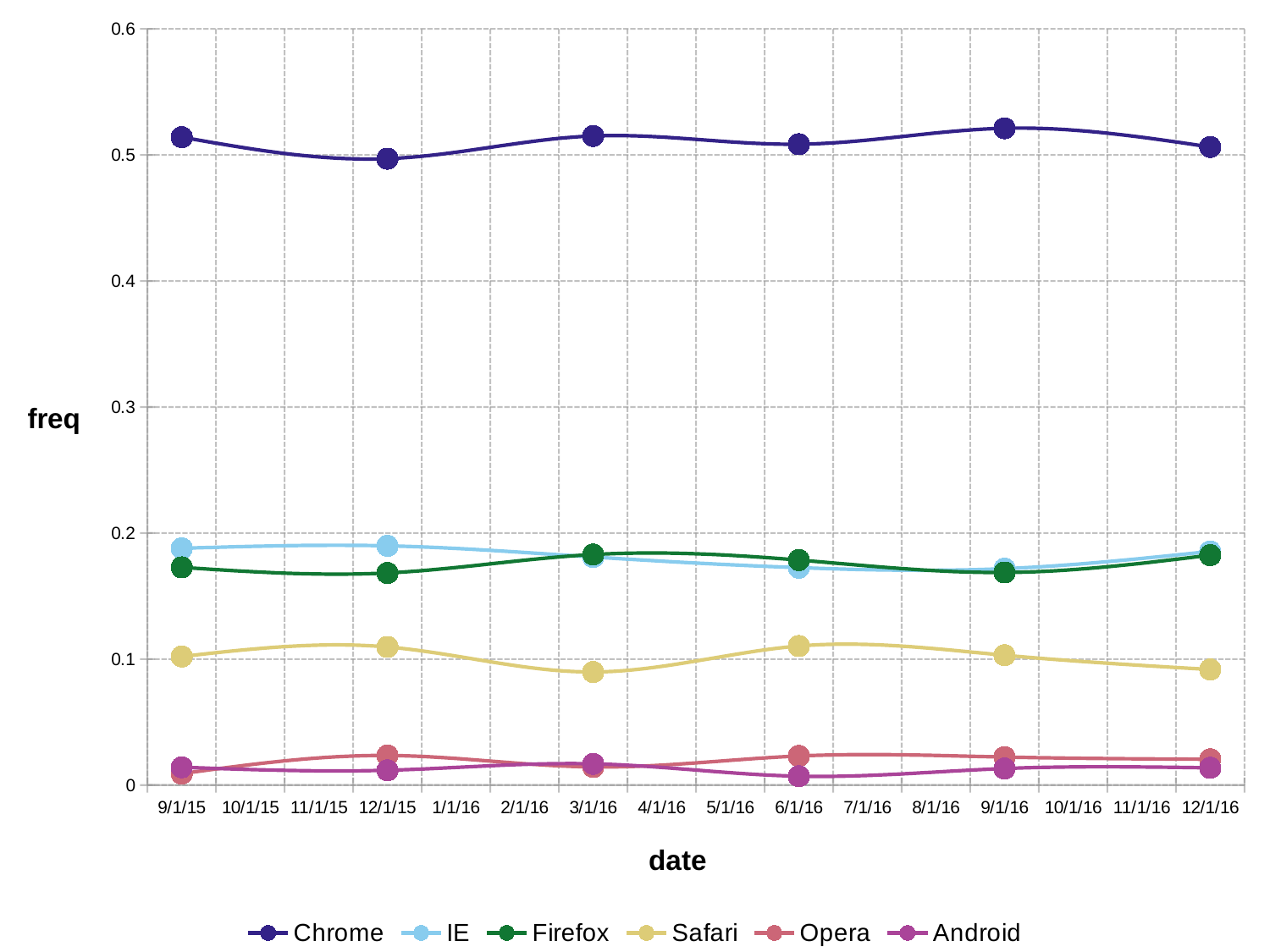
Is the value for Chrome on 9/1/16 greater or less than 0.5? greater Which series has the highest values across all dates? Chrome How many data points are plotted for the Chrome series? 6 How many series does the legend list? 6 Is the value for IE on 12/1/15 greater or less than 0.2? less Which is larger on 3/1/16, the value for Safari or the value for Opera? Safari Does the Safari series rise or fall from 9/1/16 to 12/1/16? fall What is the label on the vertical axis? freq What kind of chart is shown on the slide? line chart On which date does the Chrome series reach its highest value? 9/1/16 Which is larger on 12/1/15, the value for IE or the value for Firefox? IE Is the value for Safari on 3/1/16 greater or less than 0.1? less